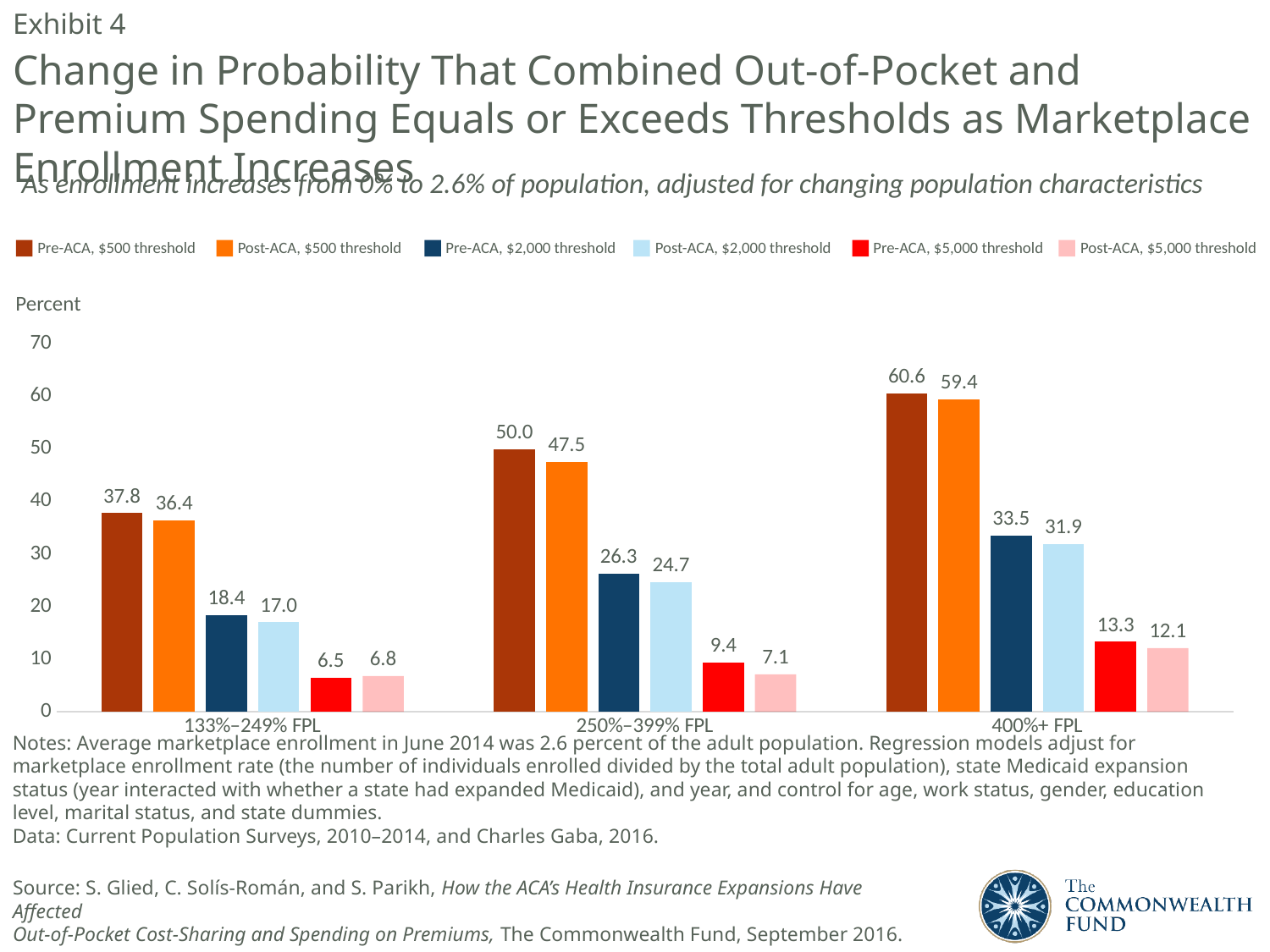
How many FPL groups are shown on the x axis? 3 Do the Pre-ACA, $2,000 threshold values rise or fall as the FPL group increases from 133%–249% to 400%+? Rise What kind of chart is shown on the slide? Bar chart What is the difference between the Pre-ACA, $500 threshold and Post-ACA, $500 threshold values in the 400%+ FPL group? 1.2 How many series does the legend list? 6 What is the value for Pre-ACA, $5,000 threshold in the 400%+ FPL group? 13.3 Which FPL group has the lowest value for Pre-ACA, $2,000 threshold? 133%–249% FPL What is the value for Post-ACA, $2,000 threshold in the 250%–399% FPL group? 24.7 In the 133%–249% FPL group, which is larger: Pre-ACA, $5,000 threshold or Post-ACA, $5,000 threshold? Post-ACA, $5,000 threshold Which FPL group has the highest value for Post-ACA, $500 threshold? 400%+ FPL Is the value for Pre-ACA, $500 threshold in the 250%–399% FPL group greater or less than 40? greater What is the value for Pre-ACA, $500 threshold in the 133%–249% FPL group? 37.8